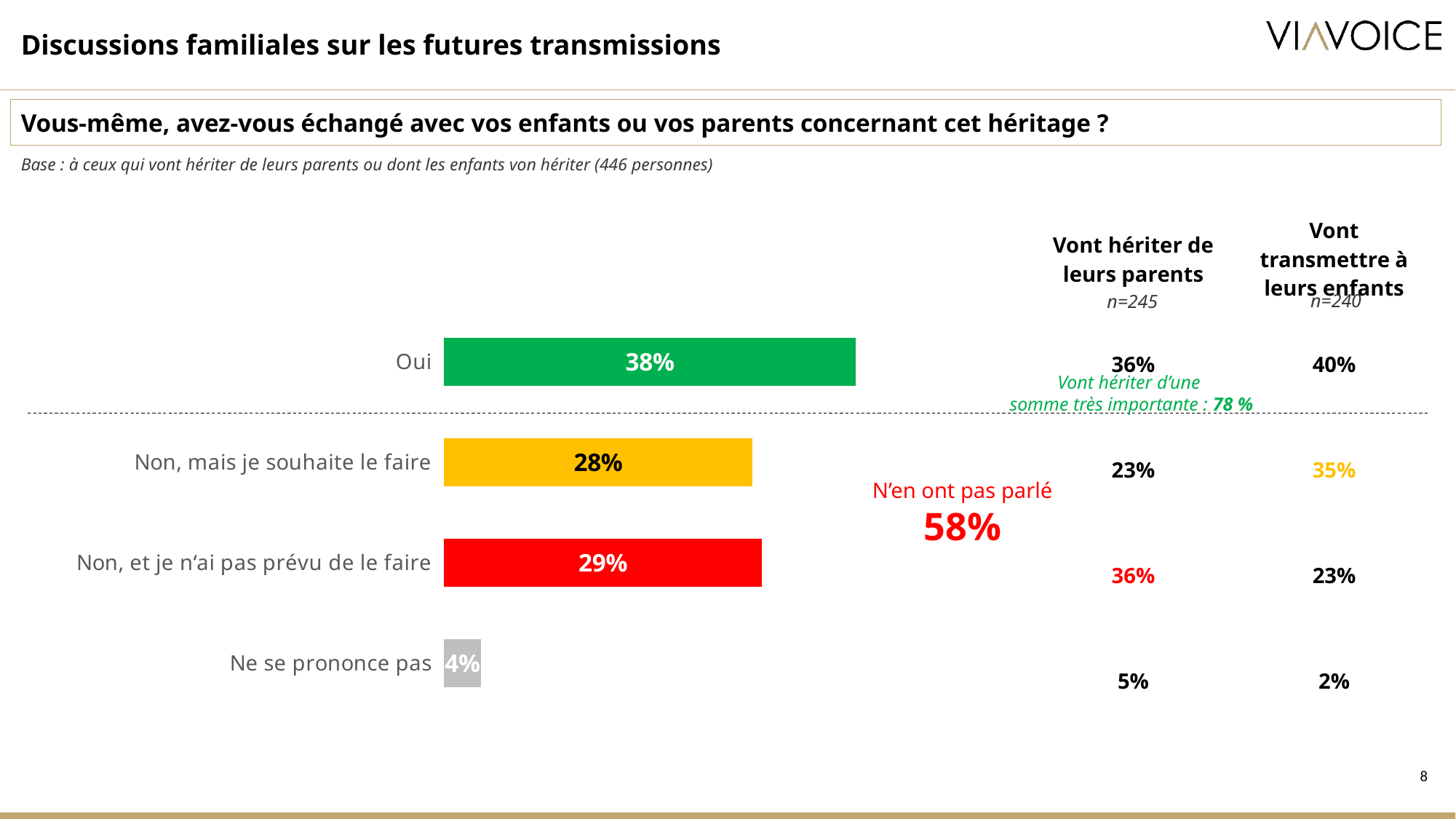
What is the value of the bar for "Ne se prononce pas"? 4% What is the value of the bar for "Non, mais je souhaite le faire"? 28% How many categories are shown in the bar chart? 4 What is the value of the bar for "Non, et je n'ai pas prévu de le faire"? 29% Which is larger: the bar for "Non, mais je souhaite le faire" or the bar for "Non, et je n'ai pas prévu de le faire"? Non, et je n'ai pas prévu de le faire What is the difference between the bar for "Oui" and the bar for "Non, mais je souhaite le faire"? 10% Which category has the lowest bar? Ne se prononce pas What is the combined share of respondents who did not discuss the inheritance ("N'en ont pas parlé") shown on the slide? 58% What colour is the bar for "Oui"? Green What is the value of the bar for "Oui"? 38% What kind of chart is shown on the slide? Bar chart Which category has the highest bar? Oui